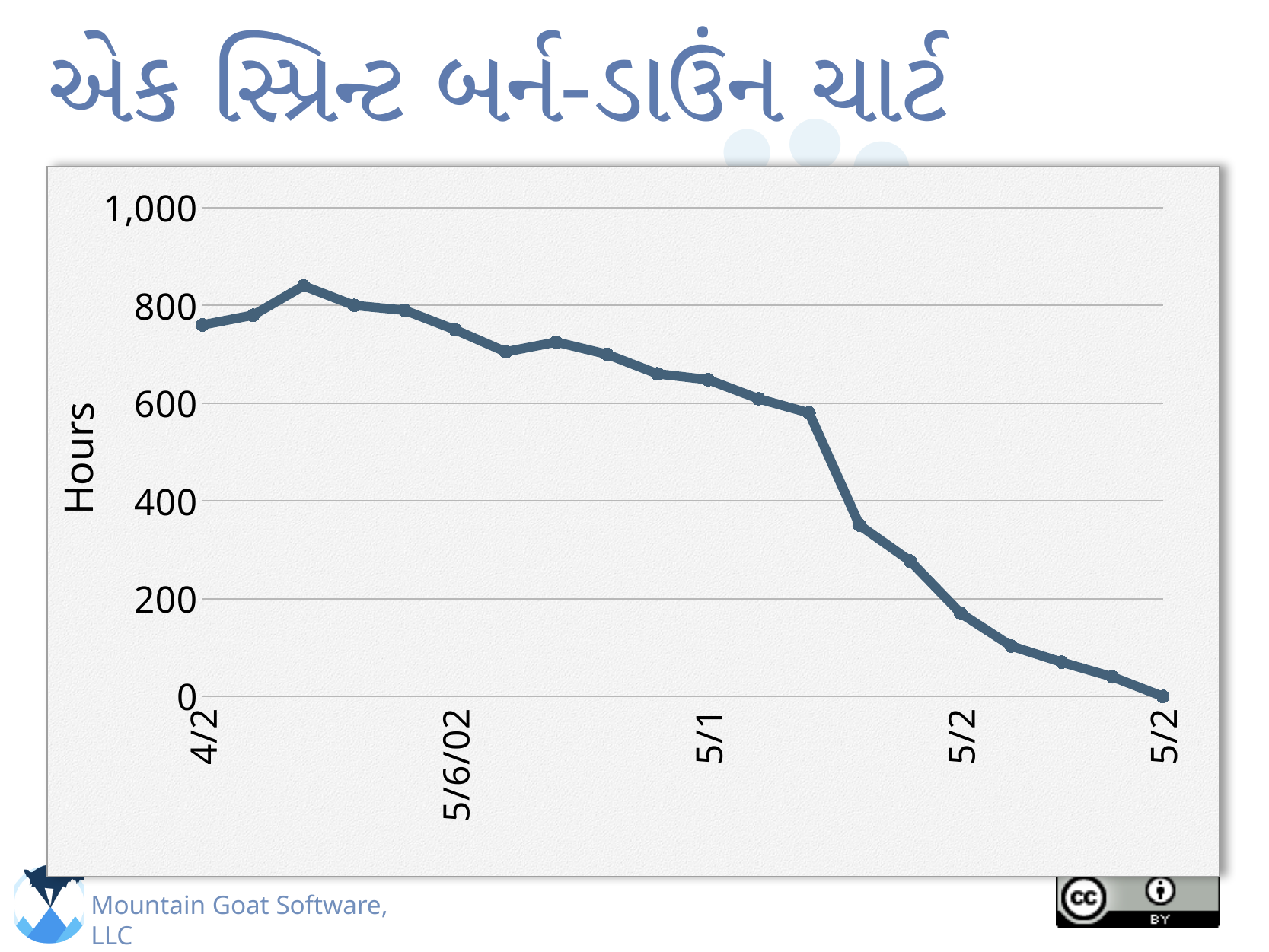
What is the label on the vertical axis of the chart? Hours What is the highest value shown on the vertical axis? 1,000 How many data points are plotted on the line? 20 Is the value at 5/1 greater or less than 400? greater How many lines are plotted on the chart? 1 Overall, do the values rise or fall from left to right along the x axis? fall Is the value at 5/6/02 greater or less than 600? greater Is the value at 4/2 greater or less than 600? greater Is the value at 4/2 larger or smaller than the value at the last point on the right? larger What kind of chart is shown on the slide? line chart